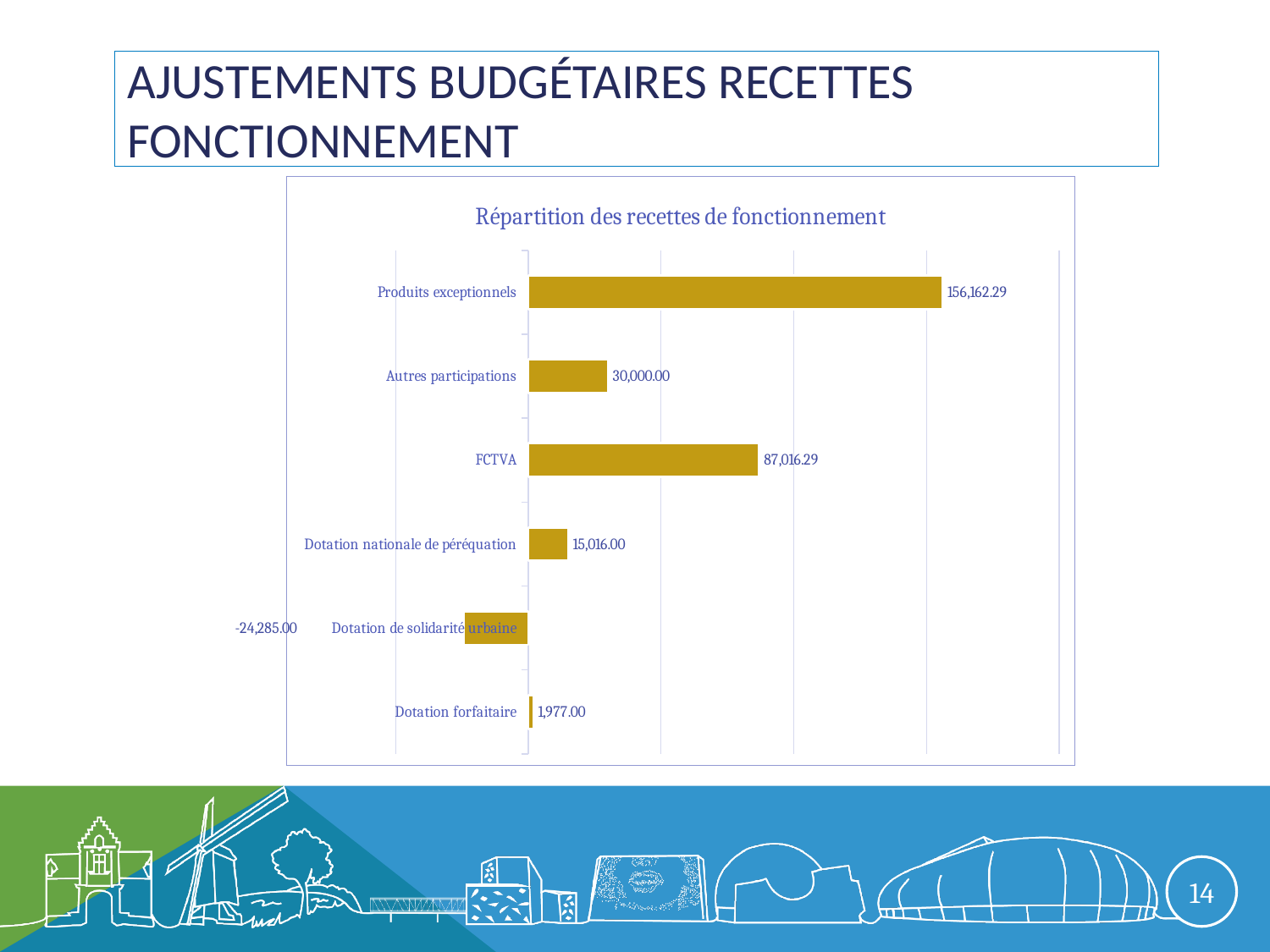
Which category has the highest value? Produits exceptionnels What kind of chart is shown on the slide? Bar chart What is the value for Produits exceptionnels? 156,162.29 What is the value for FCTVA? 87,016.29 What is the value for Dotation de solidarité urbaine? -24,285.00 What is the difference between the values for Produits exceptionnels and FCTVA? 69,146.00 What is the value for Autres participations? 30,000.00 What is the title of the chart? Répartition des recettes de fonctionnement Which is larger, the value for Autres participations or the value for Dotation nationale de péréquation? Autres participations How many categories are shown in the chart? 6 Which category has the lowest value? Dotation de solidarité urbaine What is the value for Dotation forfaitaire? 1,977.00